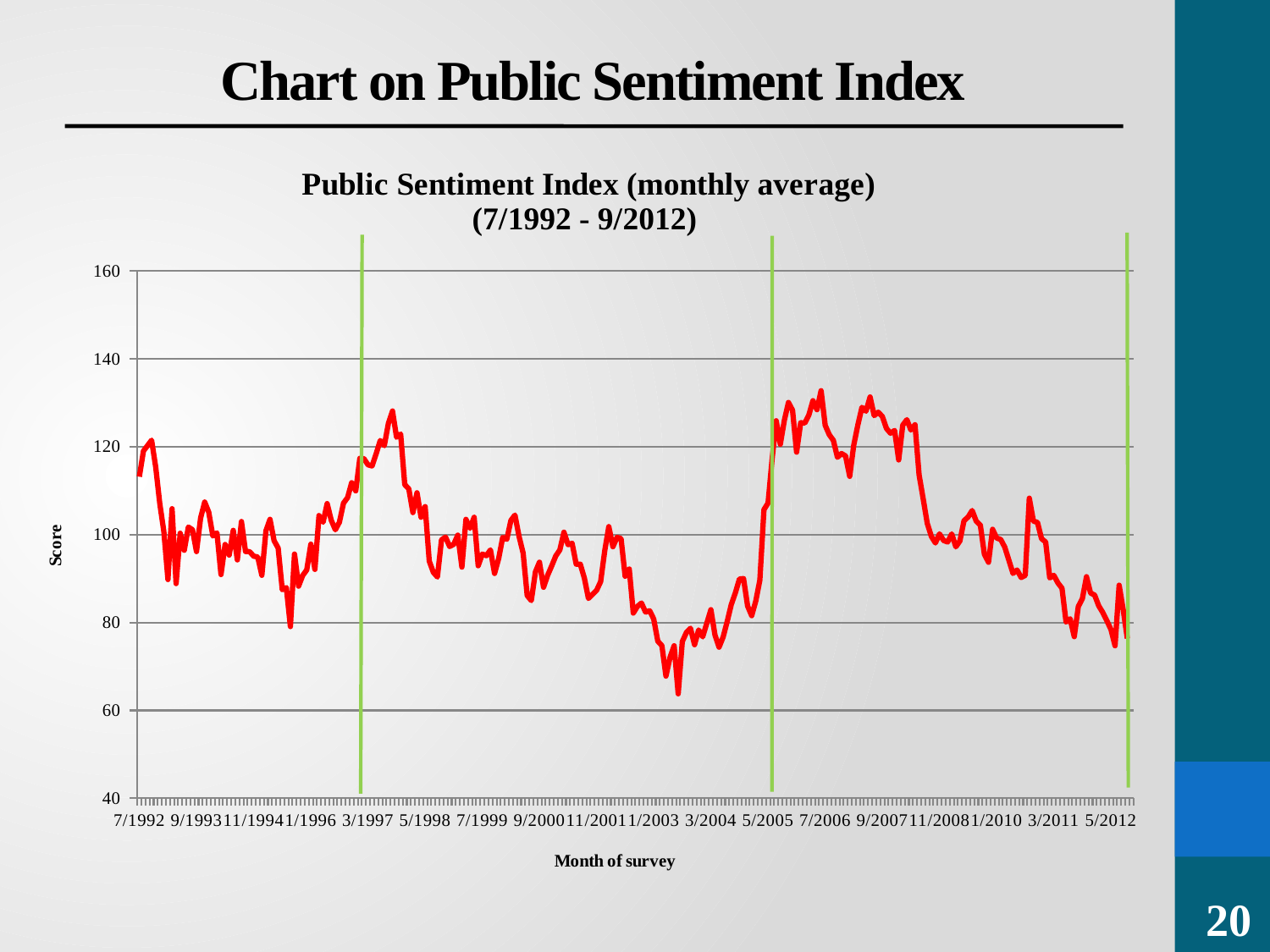
Is the lowest point on the line greater or less than 80? less Is the value around 5/2012 greater or less than 100? less Is the value around 7/2006 greater or less than 120? greater Does the line generally rise or fall between 3/2004 and 5/2005? rise Does the line generally rise or fall between 5/2005 and 5/2012? fall What is the title of the chart? Public Sentiment Index (monthly average) (7/1992 - 9/2012) What is the highest value shown on the vertical axis? 160 What kind of chart is shown on the slide? line chart What is the label of the vertical axis? Score Is the value around 7/2006 larger or smaller than the value around 1/2003? larger